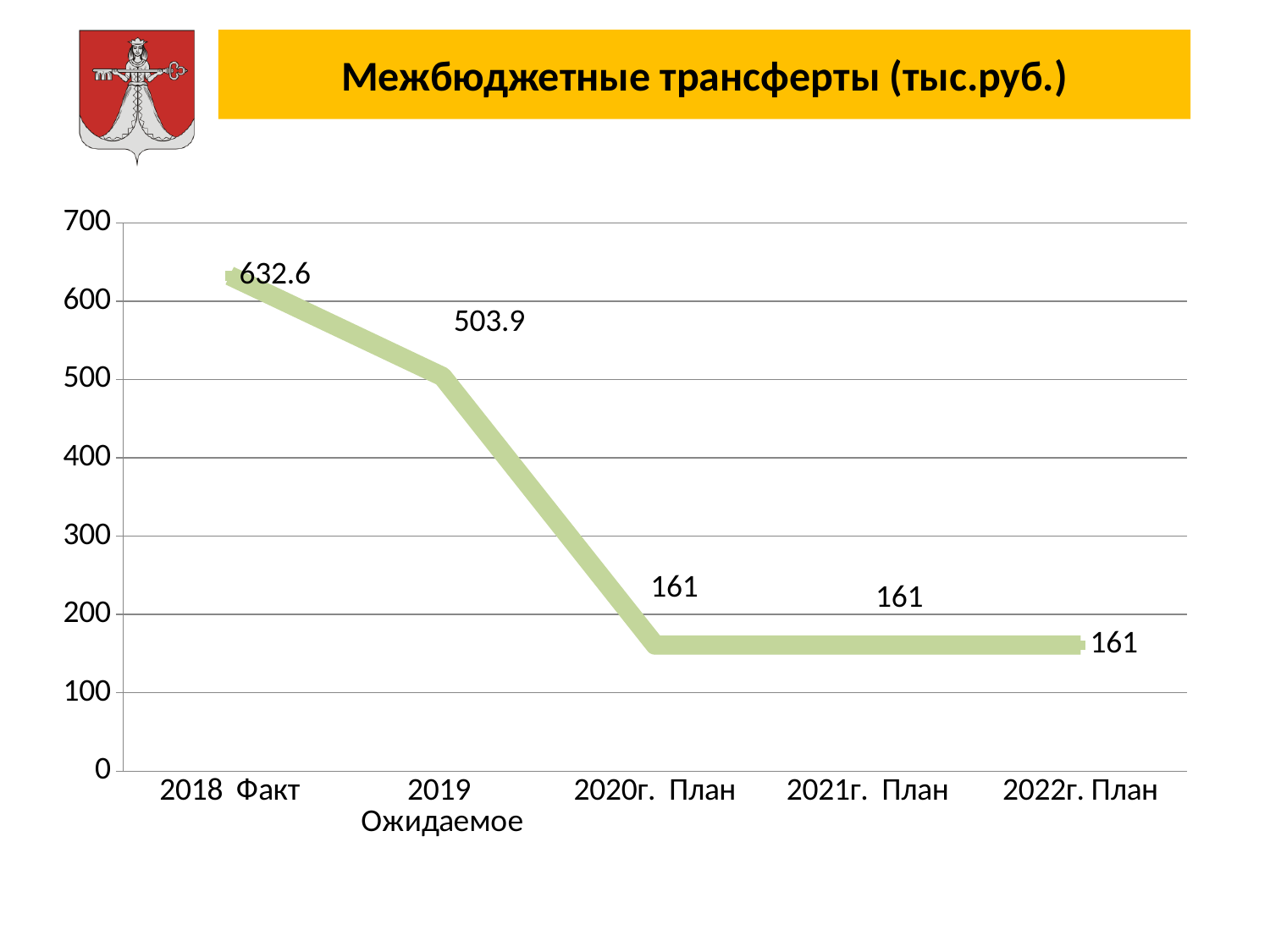
What is the difference between the values for 2019 Ожидаемое and 2020г. План? 342.9 What kind of chart is this? line chart Is the value for 2019 Ожидаемое greater or less than 400? greater What is the value for 2022г. План? 161 What is the difference between the values for 2018 Факт and 2019 Ожидаемое? 128.7 What is the value for 2019 Ожидаемое? 503.9 Which is larger, the value for 2019 Ожидаемое or the value for 2021г. План? 2019 Ожидаемое How many categories are shown on the x axis? 5 Do the values rise or fall from 2018 Факт to 2020г. План? fall What is the value for 2020г. План? 161 What is the value for 2018 Факт? 632.6 Which category has the highest value? 2018 Факт